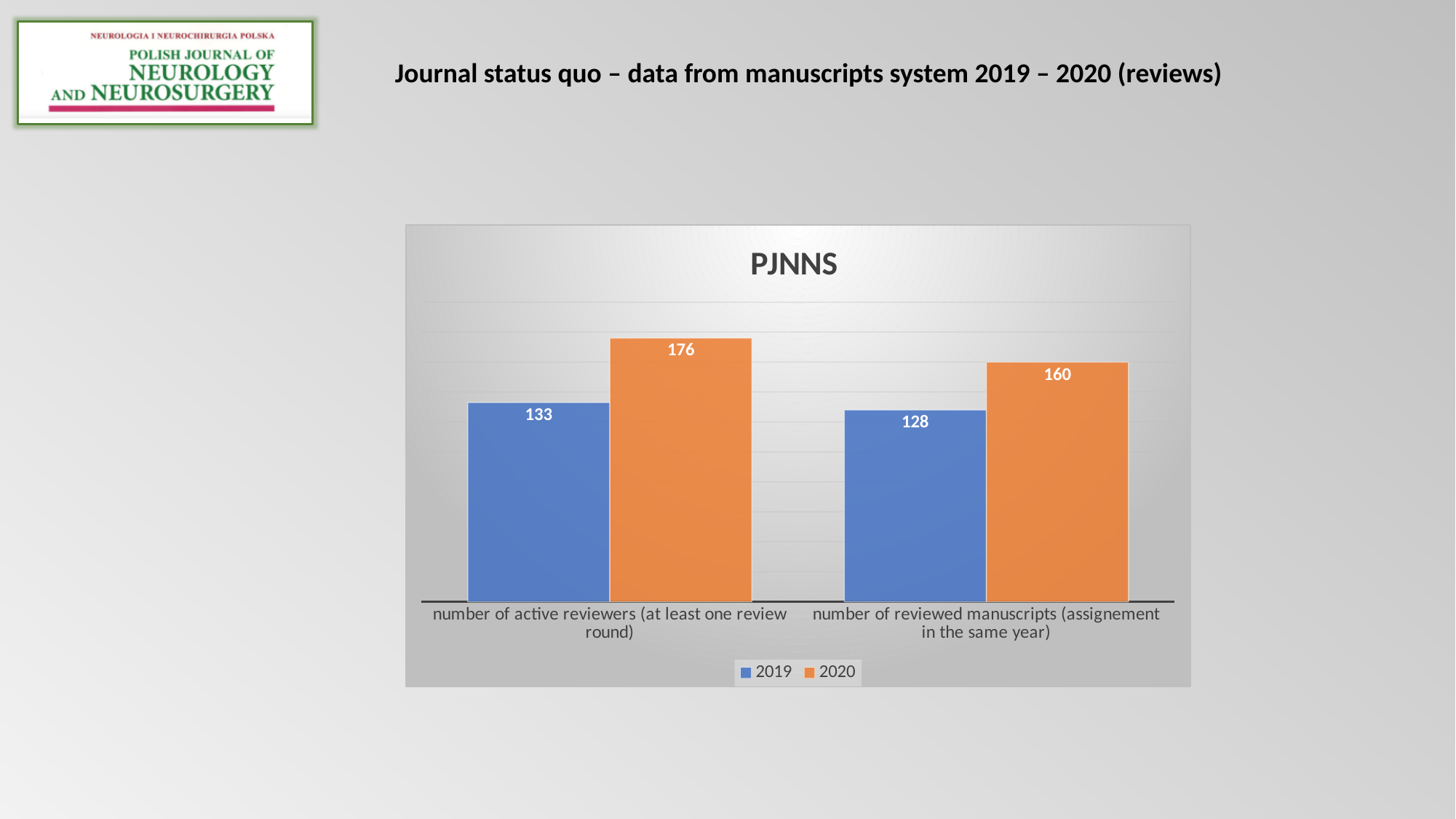
How many series does the legend list? 2 What is the number of active reviewers (at least one review round) in 2019? 133 What is the difference between the 2020 and 2019 values for number of reviewed manuscripts (assignement in the same year)? 32 What type of chart is shown on the slide? bar chart Which bar has the highest value in the chart? number of active reviewers (at least one review round), 2020 What is the difference between the 2020 and 2019 values for number of active reviewers (at least one review round)? 43 What is the number of active reviewers (at least one review round) in 2020? 176 What is the number of reviewed manuscripts (assignement in the same year) in 2019? 128 How many categories are shown on the x axis of the chart? 2 Which is larger: the 2019 value for number of active reviewers or the 2019 value for number of reviewed manuscripts? number of active reviewers (at least one review round) Which bar has the lowest value in the chart? number of reviewed manuscripts (assignement in the same year), 2019 What is the number of reviewed manuscripts (assignement in the same year) in 2020? 160